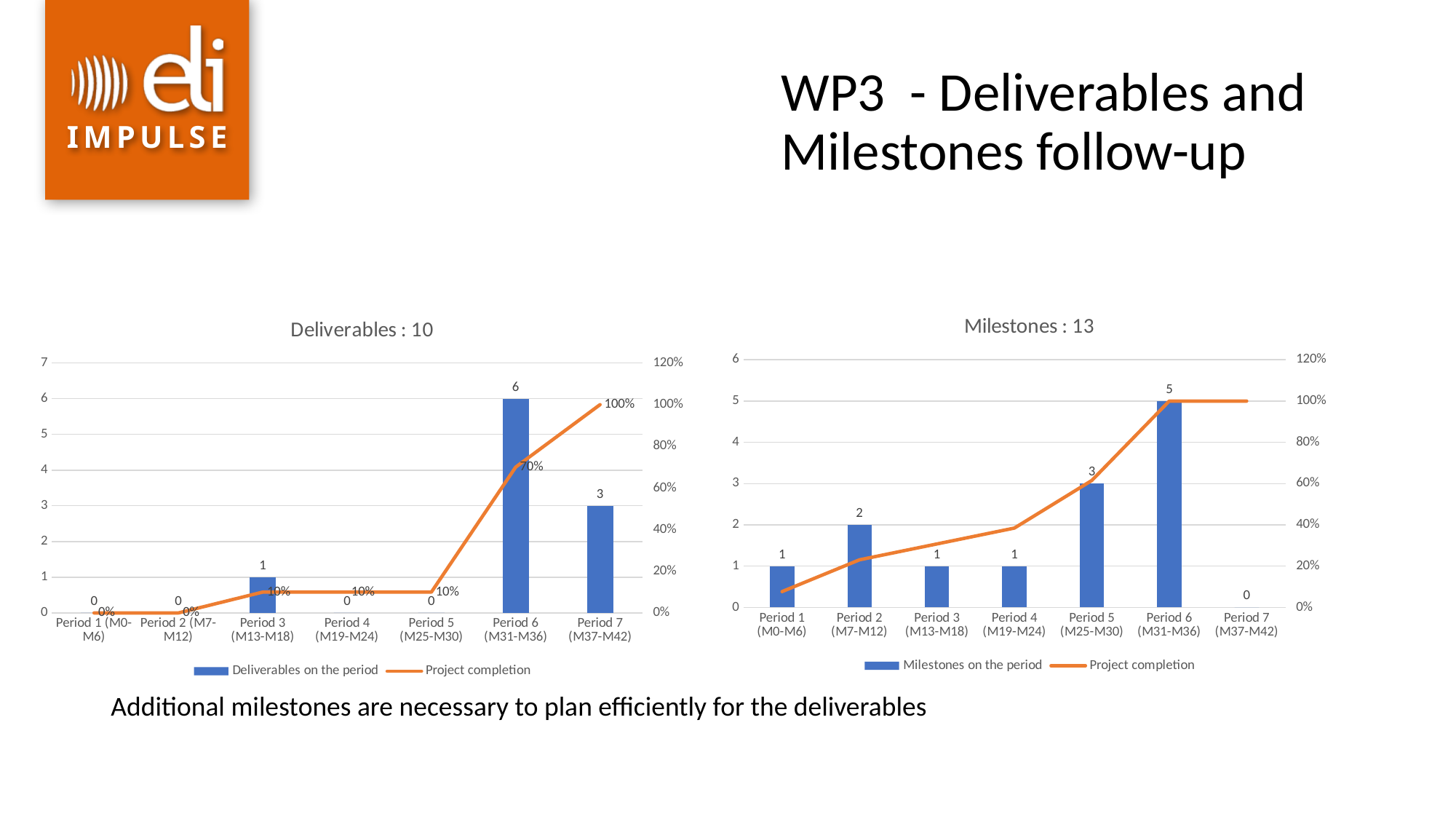
In the 'Milestones : 13' chart, which period has the highest number of milestones on the period? Period 6 (M31-M36) In the 'Deliverables : 10' chart, what is the project completion value at Period 3 (M13-M18)? 10% In the 'Deliverables : 10' chart, what is the difference in deliverables on the period between Period 6 (M31-M36) and Period 7 (M37-M42)? 3 In the 'Deliverables : 10' chart, what is the project completion value at Period 6 (M31-M36)? 70% How many periods are shown on the x axis of the 'Milestones : 13' chart? 7 In the 'Milestones : 13' chart, which period has the lowest number of milestones on the period? Period 7 (M37-M42) In the 'Deliverables : 10' chart, how many deliverables are on the period for Period 6 (M31-M36)? 6 How many series does the legend of the 'Deliverables : 10' chart list? 2 In the 'Milestones : 13' chart, how many milestones are on the period for Period 5 (M25-M30)? 3 In the 'Milestones : 13' chart, which is larger: milestones on the period for Period 2 (M7-M12) or Period 4 (M19-M24)? Period 2 (M7-M12) In the 'Milestones : 13' chart, is the project completion value at Period 5 (M25-M30) greater or less than 40%? greater In the 'Deliverables : 10' chart, which period has the highest number of deliverables on the period? Period 6 (M31-M36)